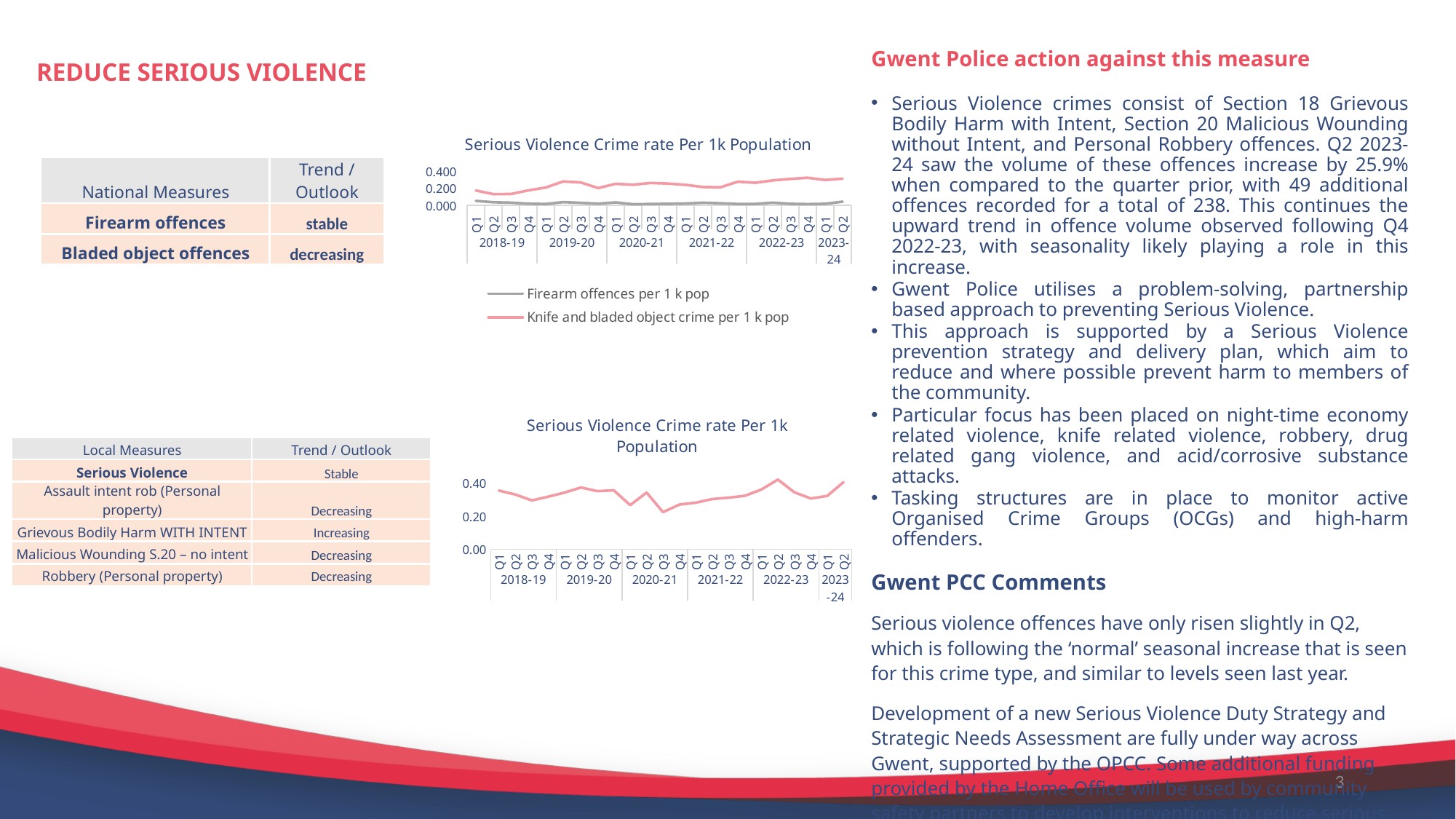
In the top chart, is the value for Firearm offences per 1 k pop in Q1 2018-19 greater or less than 0.200? less In the top chart, which series is plotted higher throughout: Firearm offences per 1 k pop or Knife and bladed object crime per 1 k pop? Knife and bladed object crime per 1 k pop In the top chart, what colour is the line for Knife and bladed object crime per 1 k pop? pink In the bottom chart, how many financial years are labelled along the x axis? 6 In the bottom chart, is the value for Q1 2018-19 greater or less than 0.20? greater In the bottom chart, which quarter has the lowest value? Q3 2020-21 What kind of chart is the bottom chart titled 'Serious Violence Crime rate Per 1k Population'? line chart In the top chart, how many quarterly points are plotted along the x axis for each series? 22 In the top chart, is the value for Knife and bladed object crime per 1 k pop in Q2 2023-24 greater or less than 0.200? greater What kind of chart is the top chart titled 'Serious Violence Crime rate Per 1k Population'? line chart How many series does the legend of the top chart list? 2